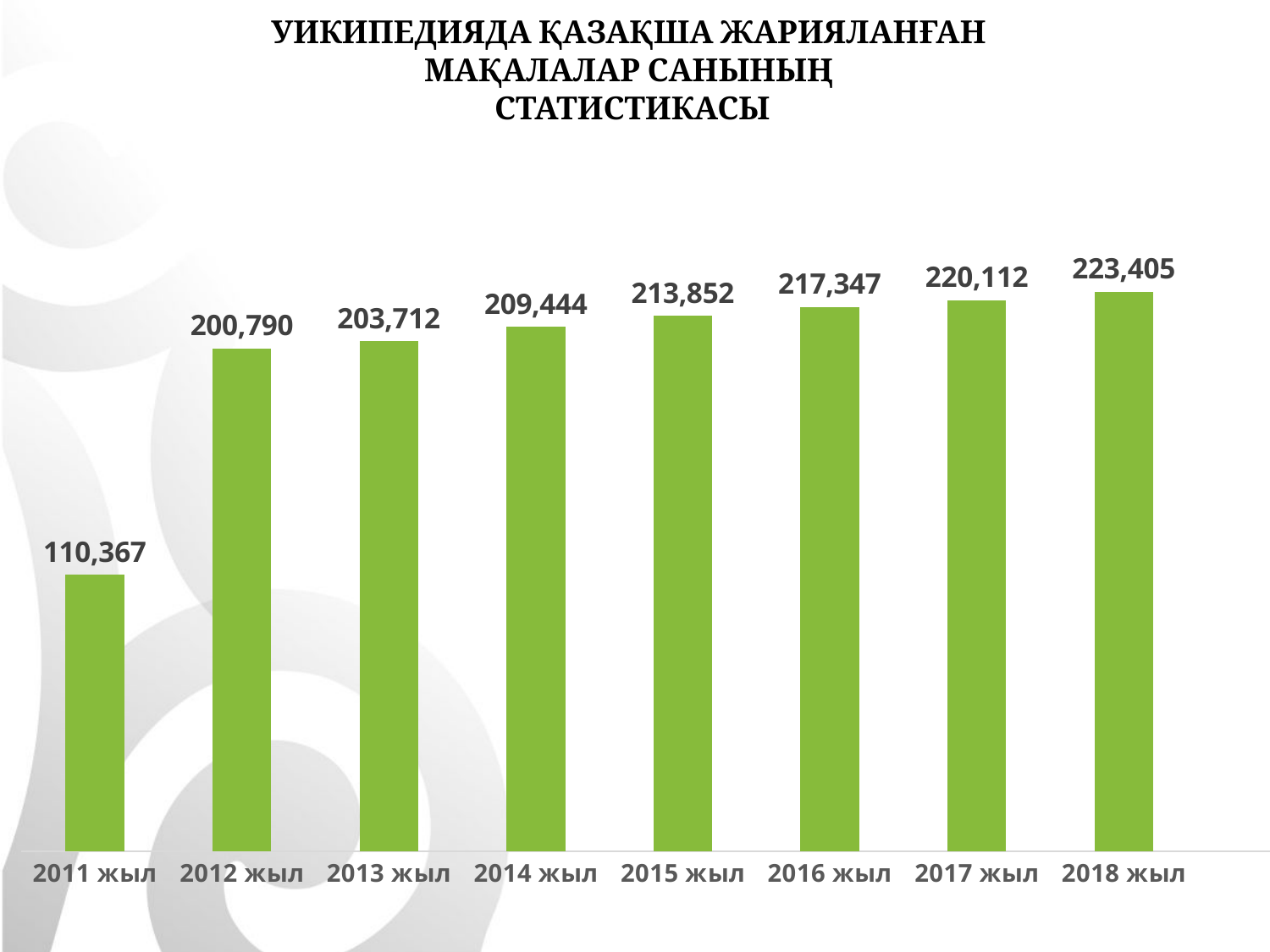
What is the value for 2012 жыл? 200,790 Which year has the highest value? 2018 жыл Which year has the lowest value? 2011 жыл What is the value for 2015 жыл? 213,852 What is the difference between the values for 2018 жыл and 2011 жыл? 113,038 What is the difference between the values for 2018 жыл and 2017 жыл? 3,293 What is the value for 2017 жыл? 220,112 Do the values rise or fall from 2011 жыл to 2018 жыл? Rise How many years are shown on the chart? 8 What is the difference between the values for 2012 жыл and 2011 жыл? 90,423 Which is larger, the value for 2013 жыл or the value for 2016 жыл? 2016 жыл What kind of chart is shown on the slide? Bar chart